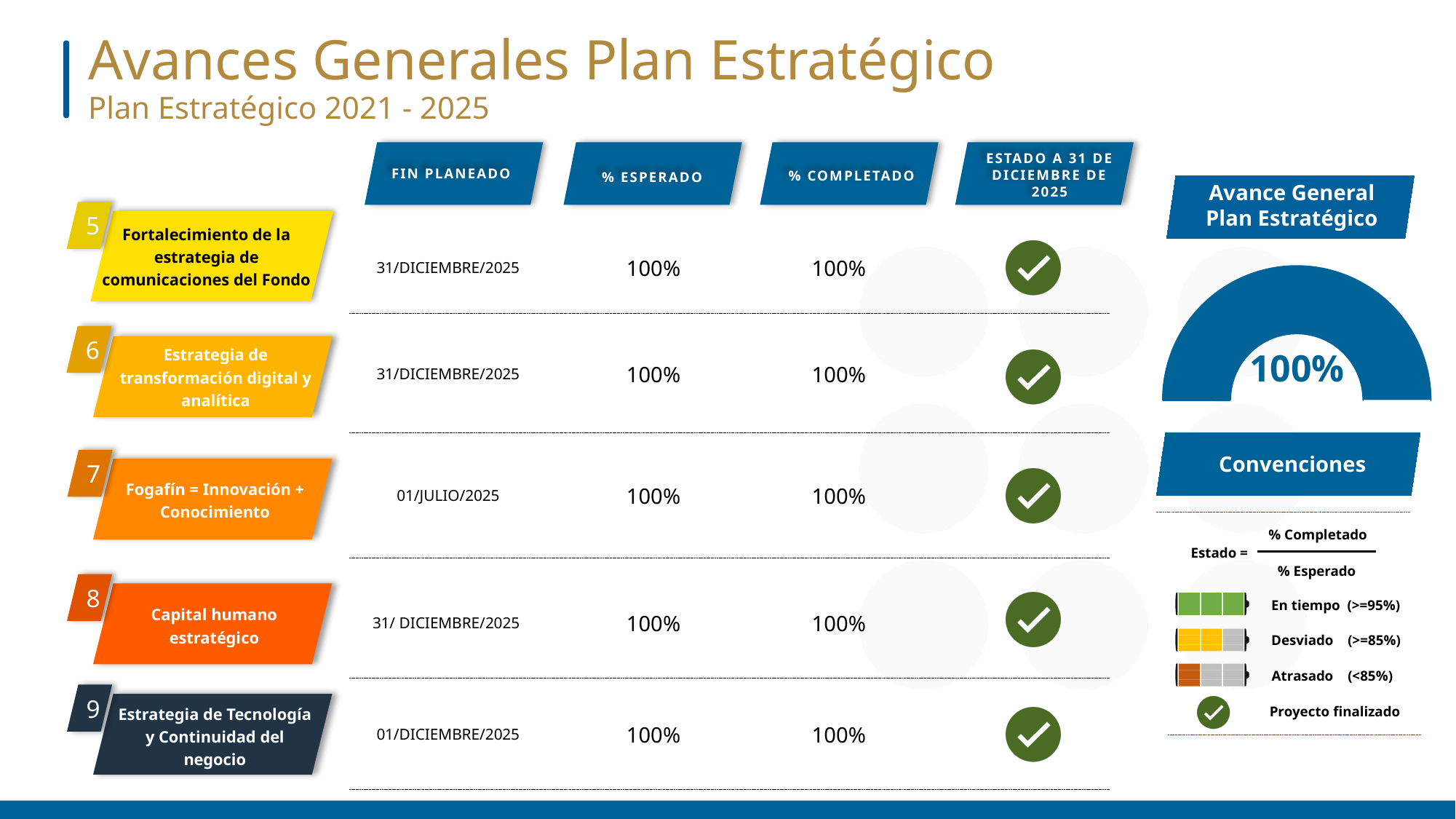
What colour is the filled arc of the 'Avance General Plan Estratégico' gauge chart? blue Is the value shown in the 'Avance General Plan Estratégico' gauge greater or less than 95%? greater What is the title shown above the gauge chart on the right of the slide? Avance General Plan Estratégico What kind of chart is used to show the 'Avance General Plan Estratégico'? gauge chart What value does the 'Avance General Plan Estratégico' gauge chart display? 100%